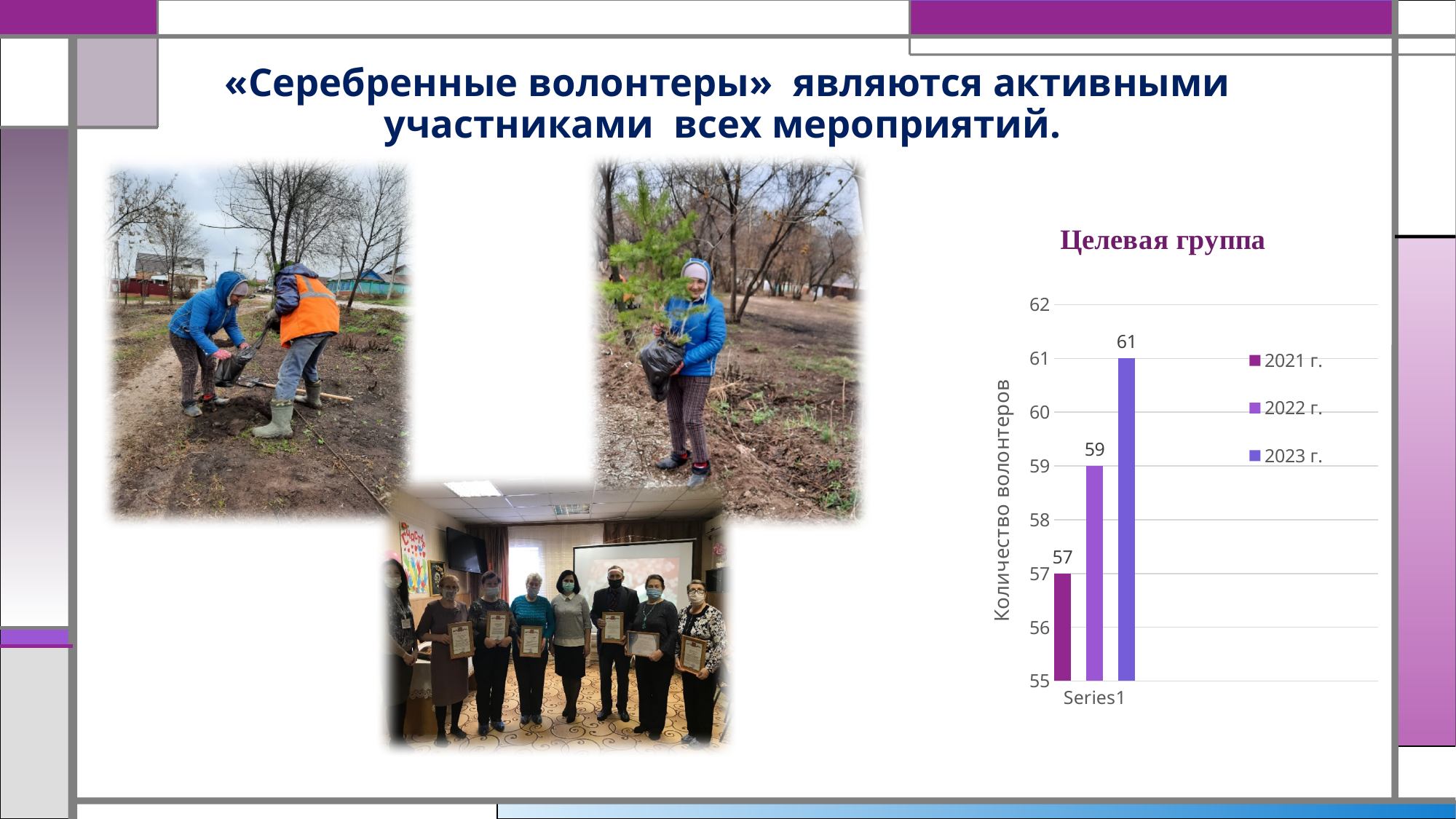
How many series does the legend list? 3 Which year has the lowest number of volunteers? 2021 г. What is the value for 2021 г. in the chart? 57 What is the title of the chart? Целевая группа Which is larger, the value for 2022 г. or the value for 2023 г.? 2023 г. What kind of chart is shown on the slide? bar chart What is the difference between the values for 2022 г. and 2021 г.? 2 What is the difference between the values for 2023 г. and 2021 г.? 4 What is the value for 2023 г. in the chart? 61 What is the value for 2022 г. in the chart? 59 Which year has the highest number of volunteers? 2023 г. Is the value for 2023 г. greater or less than 60? greater